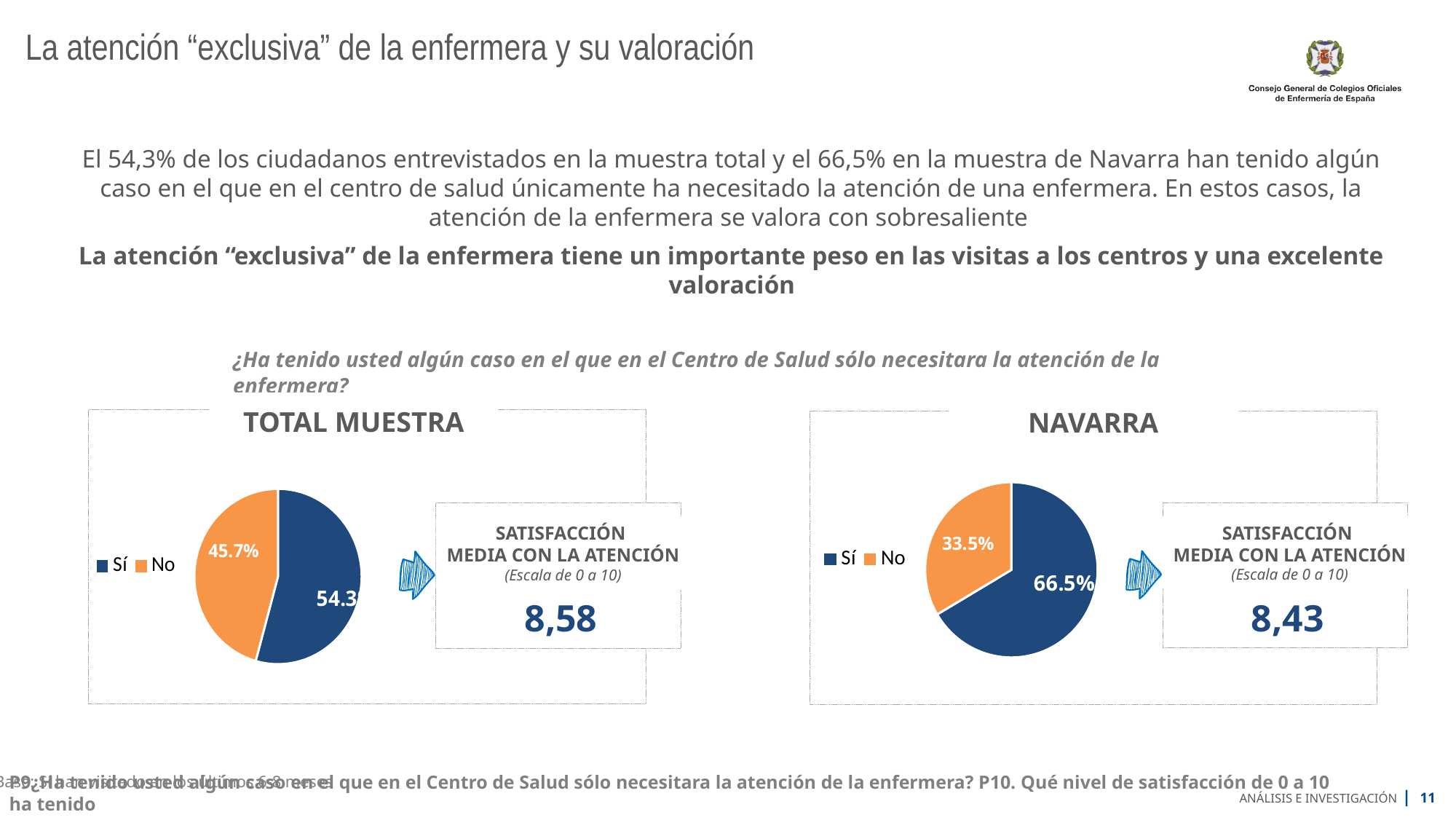
In the TOTAL MUESTRA pie chart, what is the share for Sí? 54.3% In the NAVARRA pie chart, what is the share for Sí? 66.5% In the TOTAL MUESTRA pie chart, which colour represents No? orange Is the Sí share larger in the TOTAL MUESTRA chart or in the NAVARRA chart? NAVARRA How many categories does the legend of the NAVARRA pie chart list? 2 In the TOTAL MUESTRA pie chart, what is the difference between the Sí and No shares? 8.6 percentage points In the NAVARRA pie chart, what is the share for No? 33.5% In the TOTAL MUESTRA pie chart, which category has the smallest slice? No In the NAVARRA pie chart, which category has the largest slice? Sí In the TOTAL MUESTRA pie chart, what is the share for No? 45.7% In the NAVARRA pie chart, what is the difference between the Sí and No shares? 33 percentage points What kind of chart is the TOTAL MUESTRA chart? pie chart